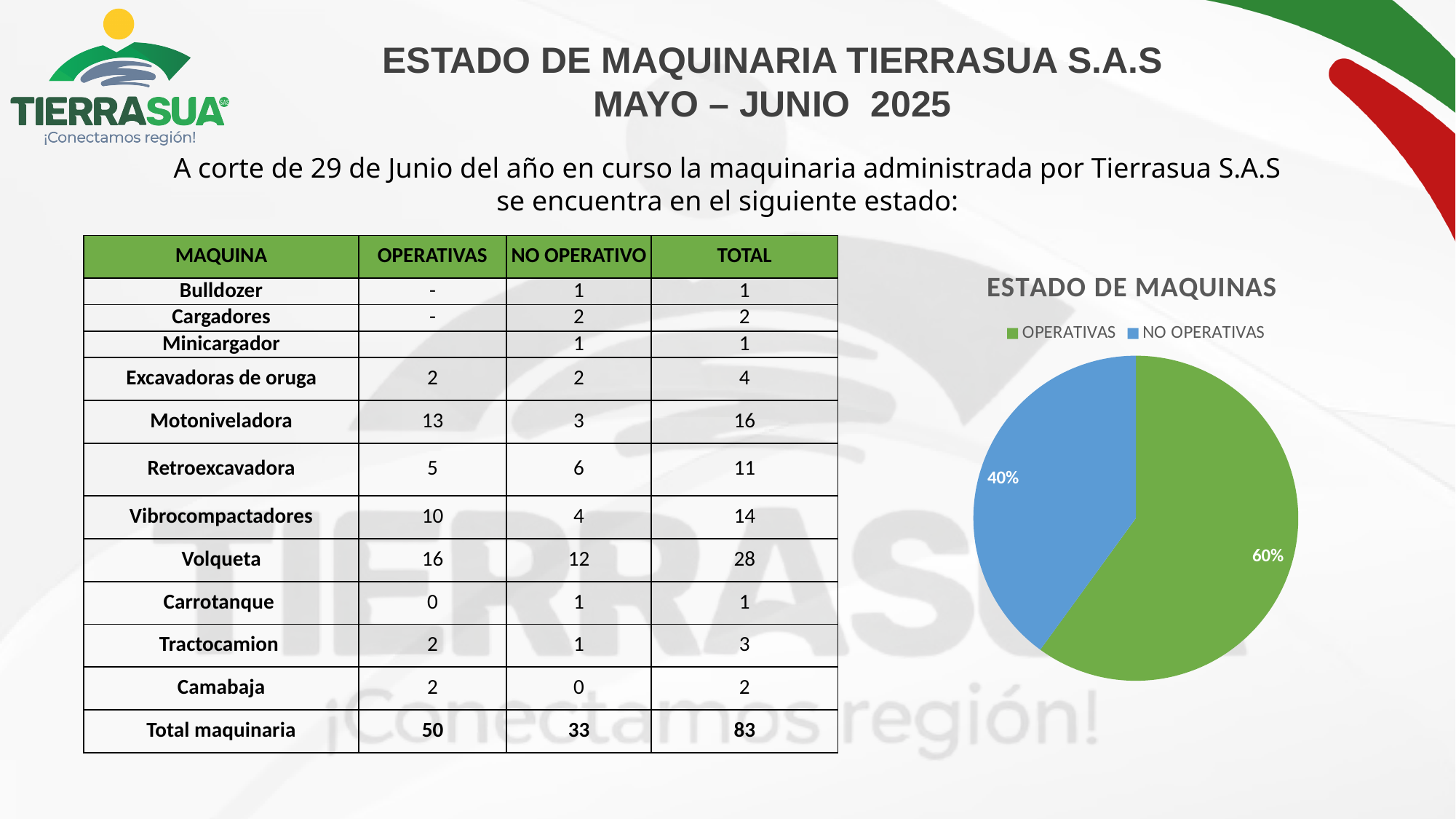
How many slices does the pie chart have? 2 Which slice of the pie chart is the smallest? NO OPERATIVAS Is the share for NO OPERATIVAS greater or less than 50%? less How many entries does the chart legend list? 2 What kind of chart is shown on the slide? pie chart What share of the pie does OPERATIVAS represent? 60% What is the title of the chart? ESTADO DE MAQUINAS What share of the pie does NO OPERATIVAS represent? 40% Which slice of the pie chart is the largest? OPERATIVAS Which is larger in the pie chart, OPERATIVAS or NO OPERATIVAS? OPERATIVAS What colour is the OPERATIVAS slice in the pie chart? green What is the difference in percentage points between the OPERATIVAS and NO OPERATIVAS slices? 20%